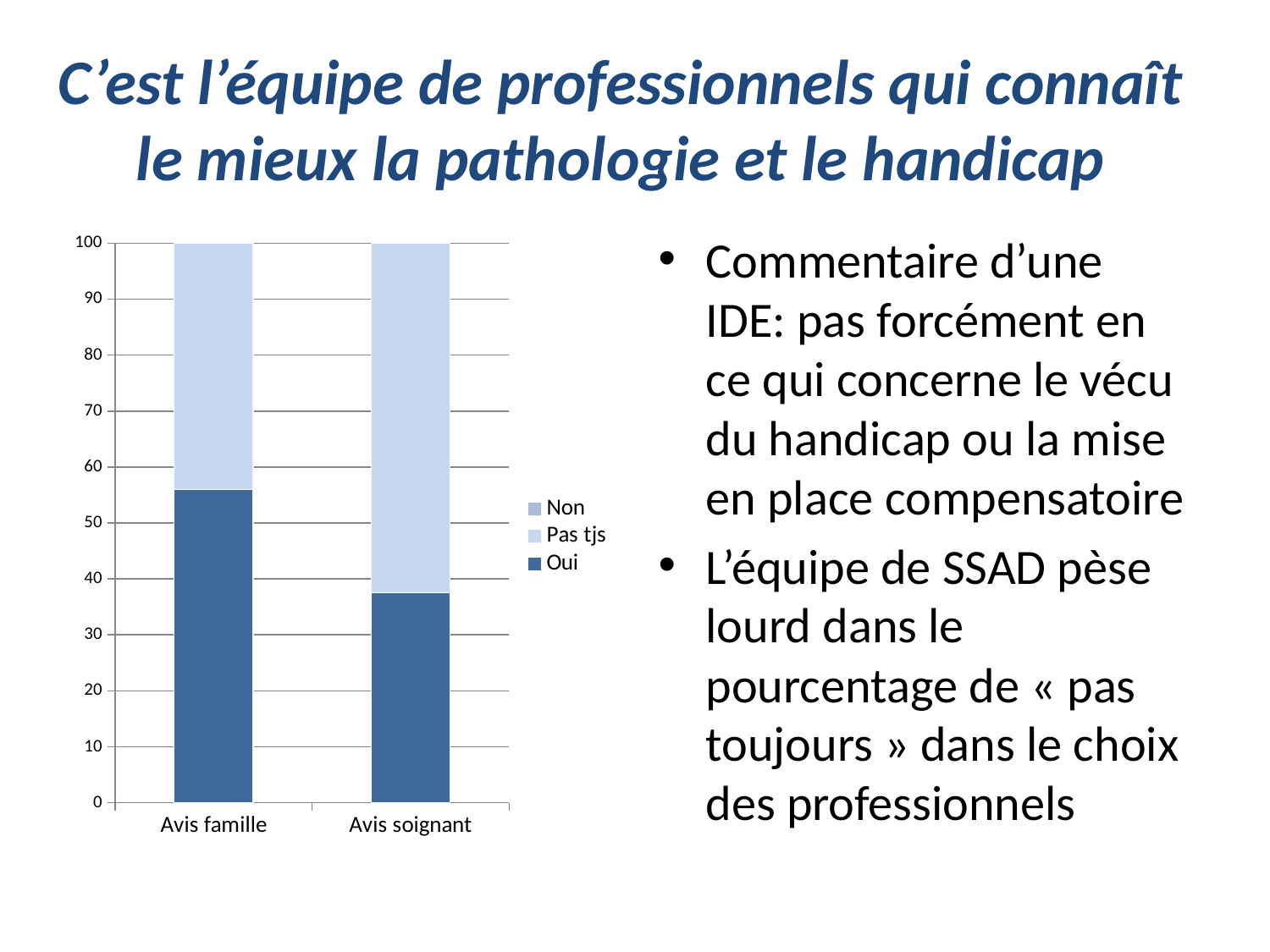
Is the 'Oui' value for Avis famille greater or less than 50? greater Which category has the lowest 'Oui' value? Avis soignant Which category has the highest 'Oui' value? Avis famille What are the entries listed in the chart legend? Non, Pas tjs, Oui Is the 'Oui' value for Avis soignant greater or less than 30? greater What kind of chart is shown on the slide? Stacked bar chart Which series is drawn in the darkest blue at the bottom of each bar? Oui What is the total height of the stacked bar for Avis famille? 100 How many categories are shown on the x axis of the chart? 2 Which category has the larger 'Oui' value, Avis famille or Avis soignant? Avis famille Is the 'Oui' value for Avis soignant greater or less than 50? less How many series does the chart legend list? 3